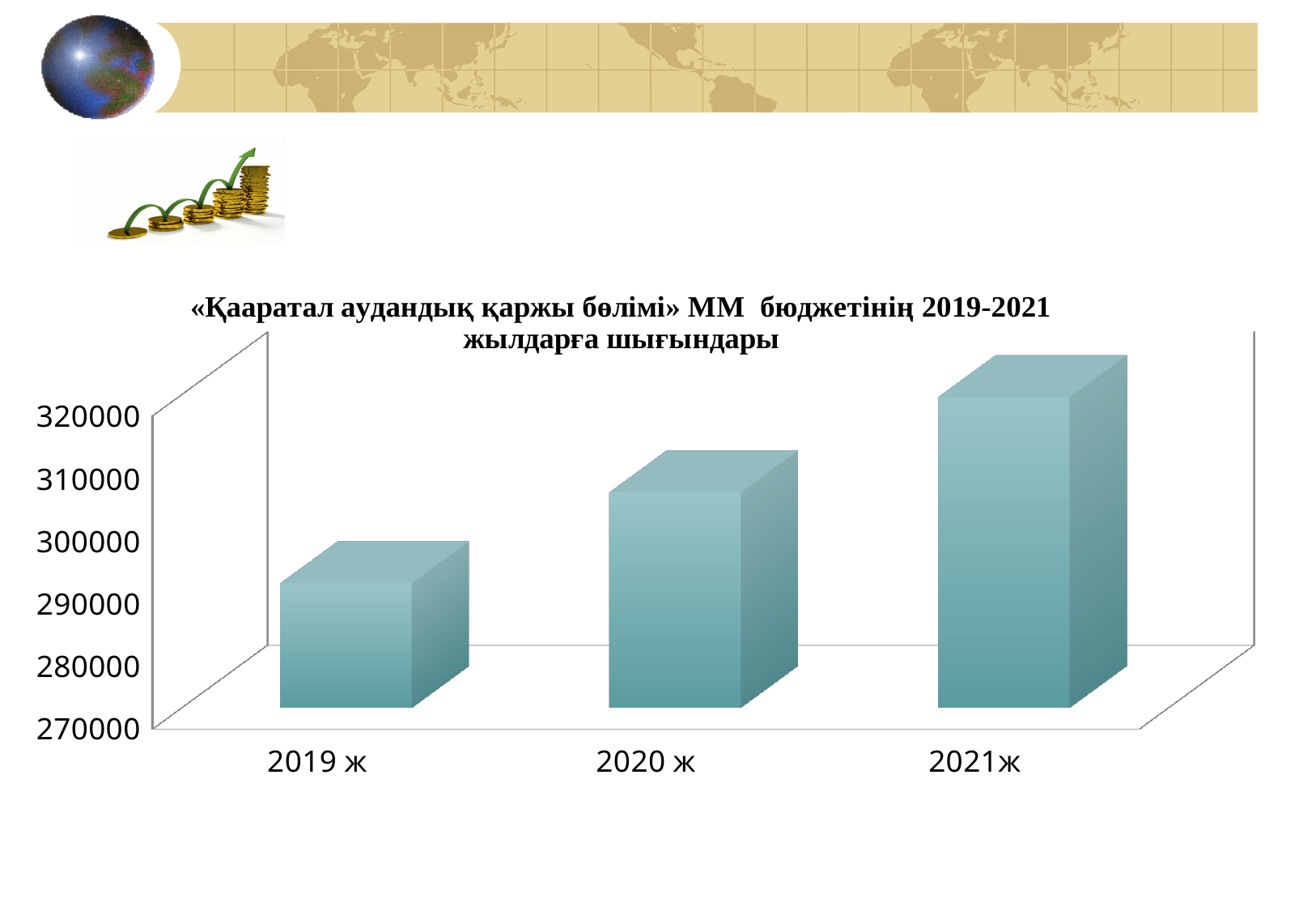
How many categories (years) are plotted on the chart? 3 Is the value for 2019 ж greater or less than 310000? less Is the value for 2019 ж greater or less than 280000? greater Which year has the highest bar? 2021ж What is the lowest value shown on the vertical axis of the chart? 270000 Which is larger, the value for 2020 ж or the value for 2019 ж? 2020 ж What kind of chart is shown on the slide? bar chart Which is larger, the value for 2021ж or the value for 2020 ж? 2021ж Do the values rise or fall from 2019 ж to 2021ж? rise Is the value for 2020 ж greater or less than 300000? greater Which year has the lowest bar? 2019 ж